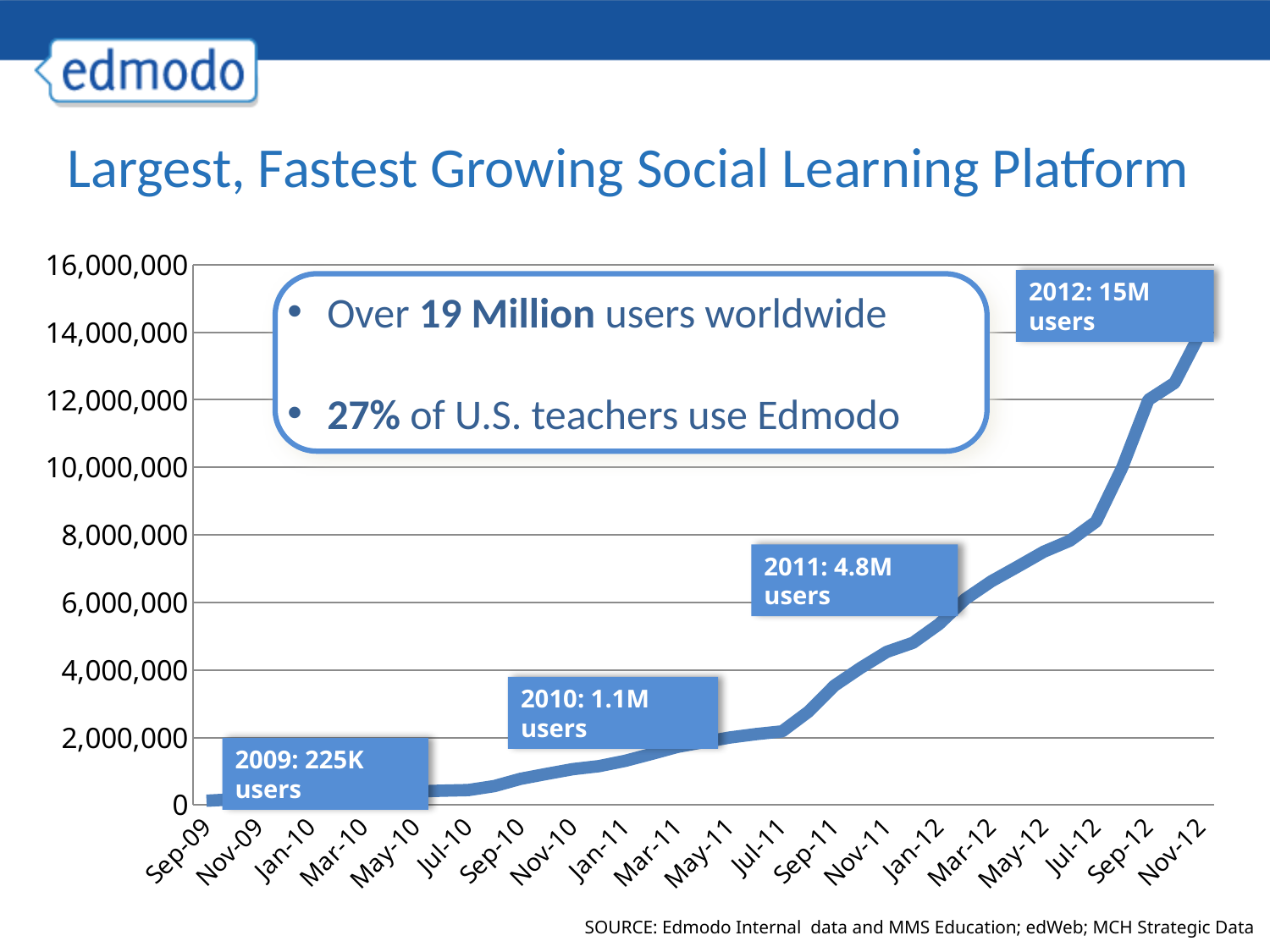
Is the value for May-12 greater or less than 8,000,000? less According to the callout on the chart, how many users did Edmodo have in 2012? 15M users Do the values rise or fall along the x axis from Sep-09 to Nov-12? rise Is the value for Nov-12 greater or less than 12,000,000? greater According to the callout on the chart, how many users did Edmodo have in 2010? 1.1M users According to the callout on the chart, how many users did Edmodo have in 2009? 225K users According to the callout on the chart, how many users did Edmodo have in 2011? 4.8M users What is the highest value shown on the y axis? 16,000,000 Which month on the x axis has the highest value? Nov-12 Is the value for Jan-11 greater or less than 2,000,000? less What kind of chart is shown on the slide? line chart Which month on the x axis has the lowest value? Sep-09